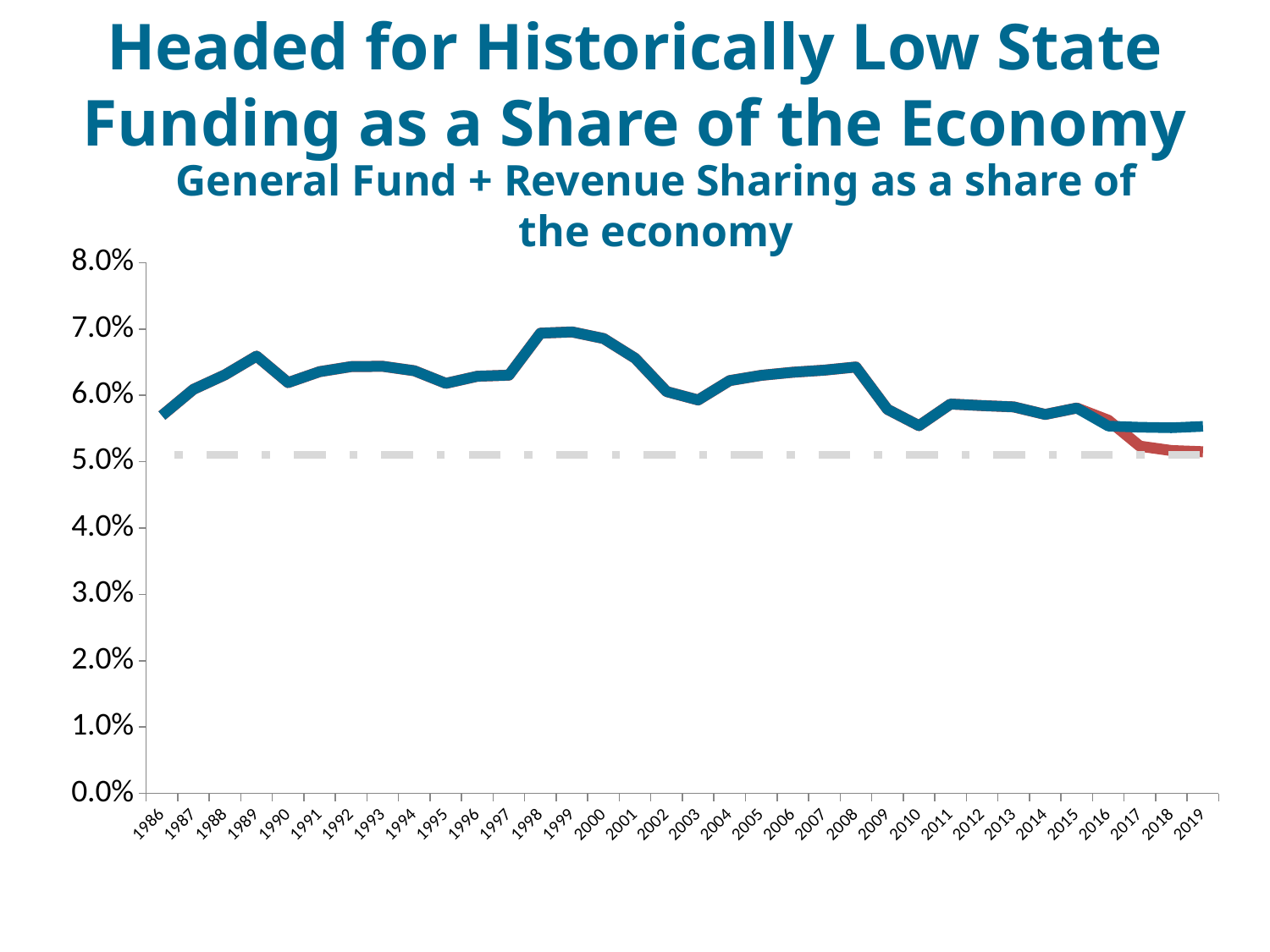
Do the values rise or fall from 2008 to 2010? fall Which year has the larger value, 2008 or 2009? 2008 Is the value for 1989 greater or less than 6.0%? greater Is the value for 2019 greater or less than 6.0%? less What kind of chart is shown on the slide? line chart Is the value for 2010 greater or less than 6.0%? less What is the subtitle of the chart? General Fund + Revenue Sharing as a share of the economy Which year has the larger value, 1999 or 2010? 1999 How many years are plotted along the x axis? 34